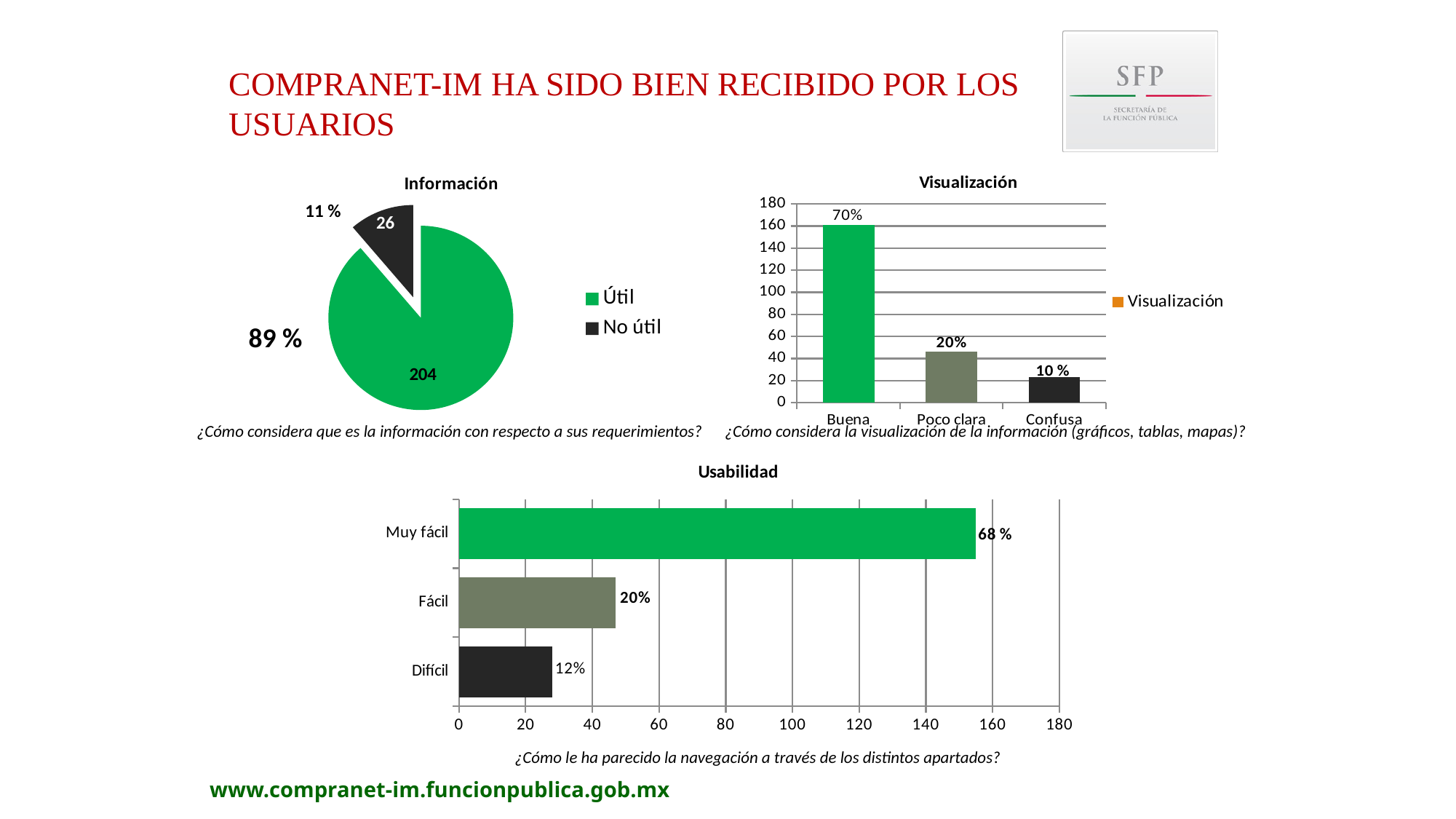
In the Información pie chart, what is the total of the two slice values? 230 In the Información pie chart, what is the difference between the Útil and No útil values? 178 In the Información pie chart, what percentage is shown for No útil? 11 % In the Visualización chart, how many categories are shown on the x axis? 3 In the Visualización chart, which category has the lowest bar? Confusa In the Usabilidad chart, what percentage label is shown for Fácil? 20% What kind of chart is the Usabilidad chart? bar chart In the Usabilidad chart, which category has the longest bar? Muy fácil In the Visualización chart, what percentage label is shown for Buena? 70% In the Usabilidad chart, is the value for Difícil greater or less than 40? less In the Información pie chart, what value is shown for the Útil slice? 204 In the Visualización chart, is the value for Buena greater or less than 140? greater